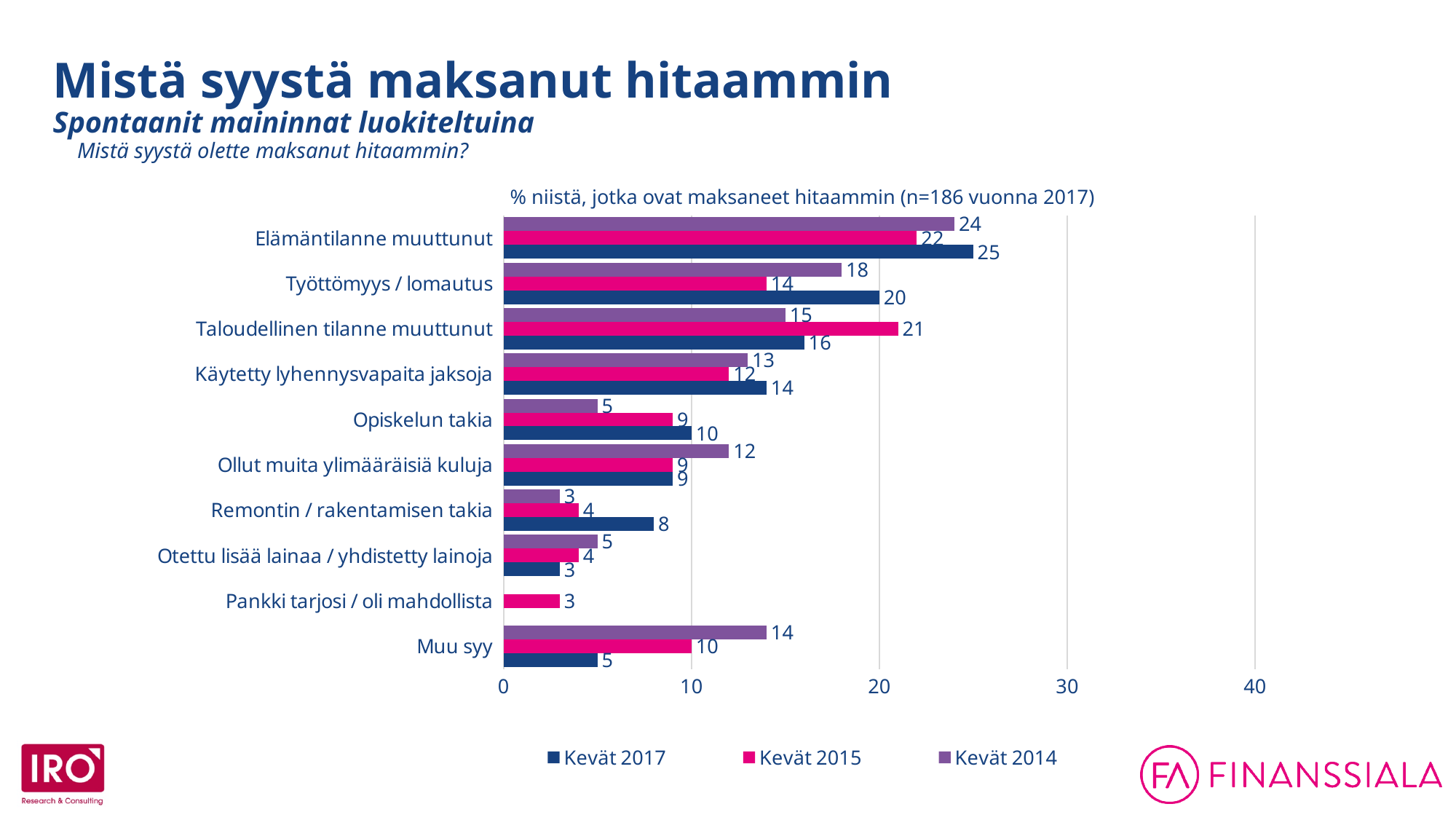
What is the difference between the Kevät 2017 and Kevät 2015 values for Työttömyys / lomautus? 6 What is the Kevät 2015 value for Taloudellinen tilanne muuttunut? 21 What is the Kevät 2014 value for Muu syy? 14 Which category has the highest Kevät 2017 value? Elämäntilanne muuttunut For Remontin / rakentamisen takia, which is larger: the Kevät 2017 value or the Kevät 2014 value? Kevät 2017 What kind of chart is shown on the slide? Bar chart Which category has the lowest Kevät 2017 value? Otettu lisää lainaa / yhdistetty lainoja What is the Kevät 2017 value for Elämäntilanne muuttunut? 25 What is the Kevät 2015 value for Opiskelun takia? 9 How many categories are shown on the chart? 10 How many series does the legend list? 3 Which series is shown for Pankki tarjosi / oli mahdollista? Kevät 2015